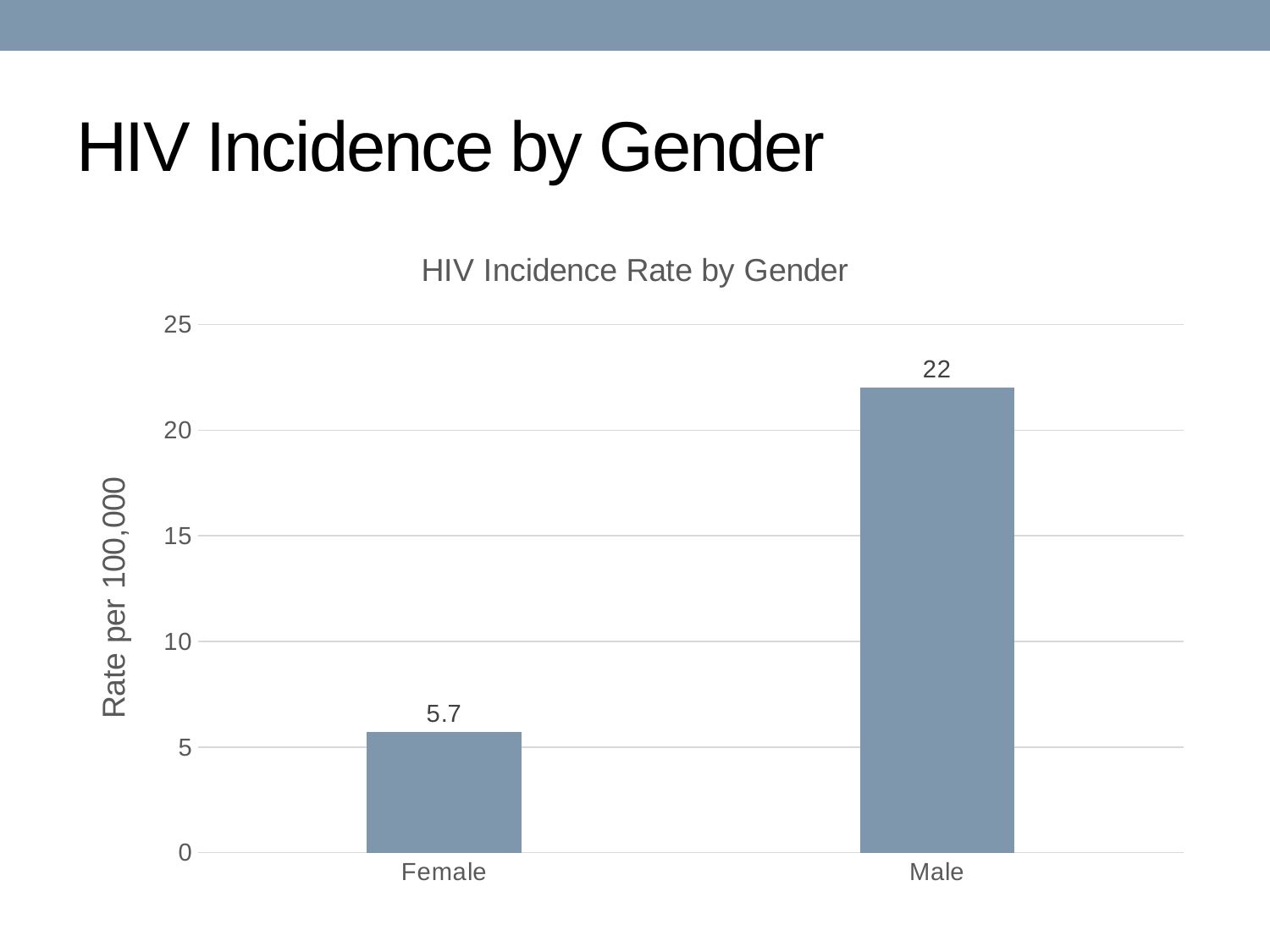
Is the value for Female greater or less than 10? less What is the HIV incidence rate for Female? 5.7 What is the label of the y axis? Rate per 100,000 Which gender has the lowest HIV incidence rate? Female Is the value for Male greater or less than 20? greater Which gender has the highest HIV incidence rate? Male What is the difference between the Male and Female HIV incidence rates? 16.3 What kind of chart is shown on the slide? bar chart How many categories are shown on the x axis? 2 What is the HIV incidence rate for Male? 22 Is the HIV incidence rate higher for Male or Female? Male What is the title of the chart? HIV Incidence Rate by Gender